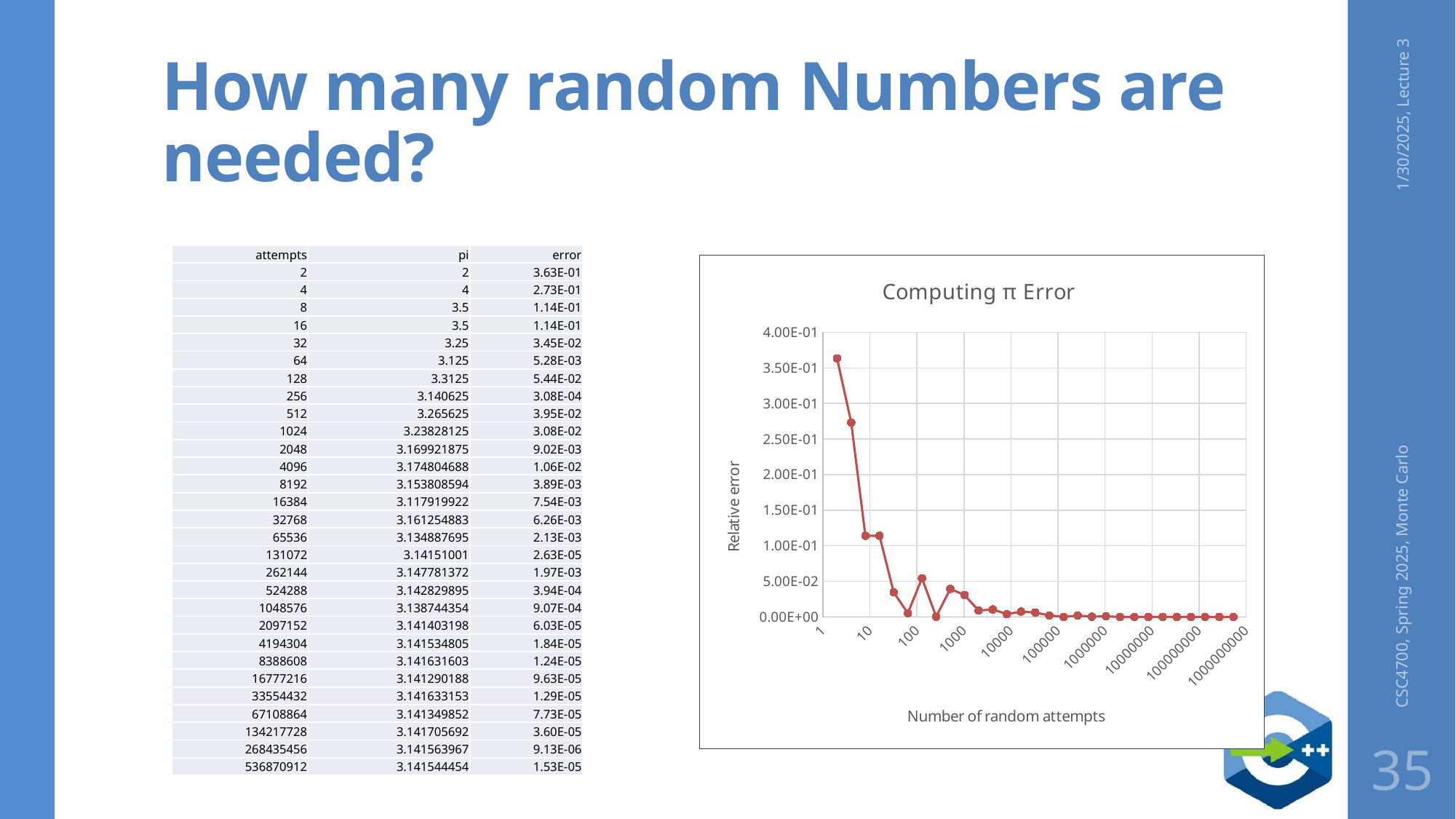
According to the table, what is the pi estimate for 536870912 attempts? 3.141544454 Which has the larger relative error: 8 attempts or 32 attempts? 8 attempts At which number of attempts is the relative error highest? 2 What kind of chart is shown on the slide? line chart What is the label of the x axis of the chart? Number of random attempts Is the relative error for 2 attempts greater or less than 3.00E-01? greater Is the relative error for 4 attempts greater or less than 3.00E-01? less How many data points are plotted on the chart? 29 Is the relative error for 1000000 attempts greater or less than 5.00E-02? less What is the title of the chart? Computing π Error According to the table, what is the error for 256 attempts? 3.08E-04 Does the relative error generally rise or fall as the number of random attempts increases? fall